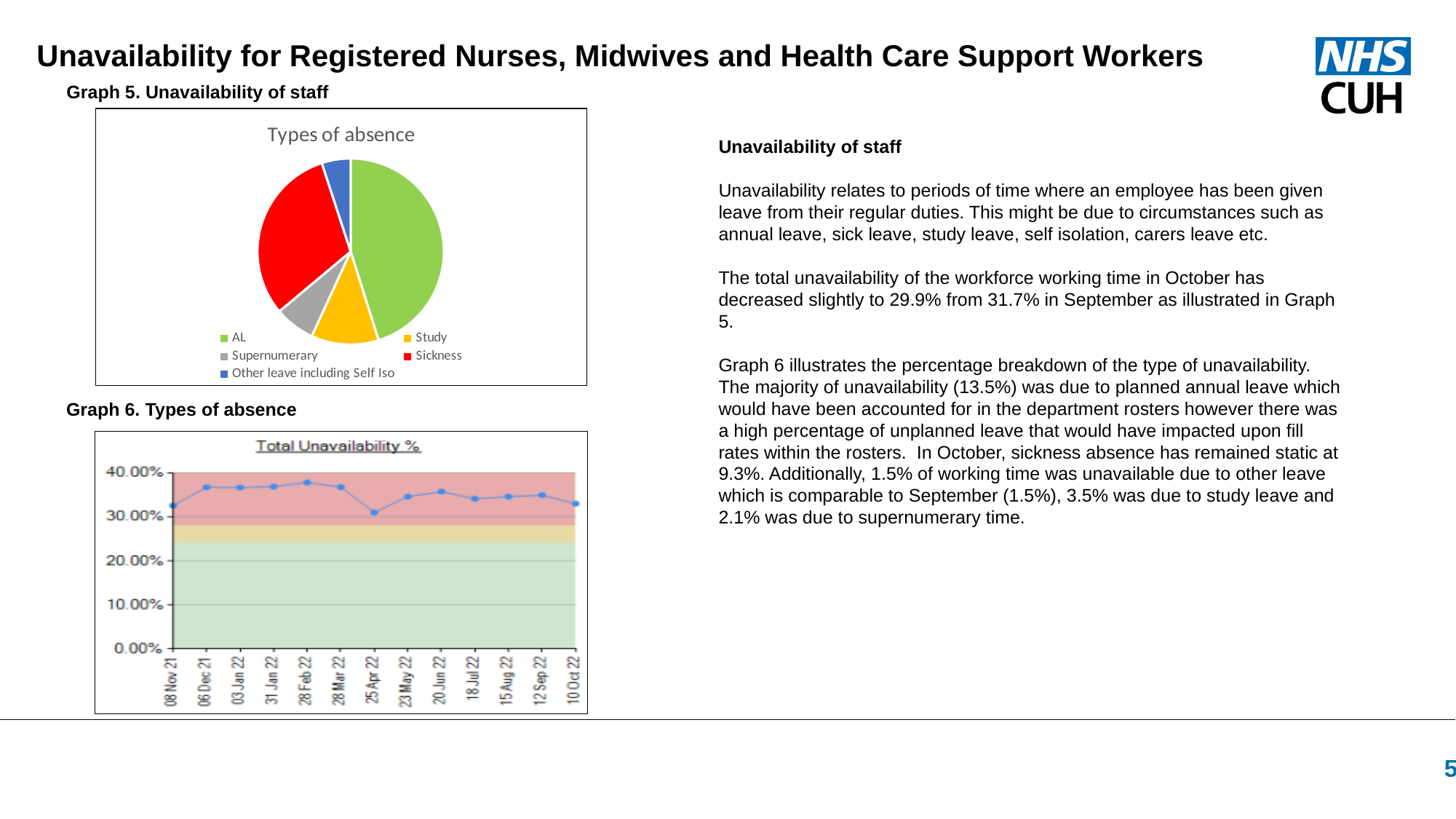
In the "Total Unavailability %" chart, which date has the lowest value? 25 Apr 22 In the "Types of absence" pie chart, what colour is the Sickness slice? red In the "Types of absence" pie chart, which slice is larger: Sickness or Study? Sickness What kind of chart is the "Total Unavailability %" chart? line chart In the "Types of absence" pie chart, which category has the largest slice? AL What kind of chart is the "Types of absence" chart? pie chart In the "Types of absence" pie chart, which category has the smallest slice? Other leave including Self Iso In the "Total Unavailability %" chart, is the value for 28 Feb 22 greater or less than 30.00%? greater In the "Total Unavailability %" chart, which date has the highest value? 28 Feb 22 How many dates are shown on the x axis of the "Total Unavailability %" chart? 13 In the "Total Unavailability %" chart, which is larger: the value for 28 Feb 22 or the value for 25 Apr 22? 28 Feb 22 How many categories does the legend of the "Types of absence" pie chart list? 5